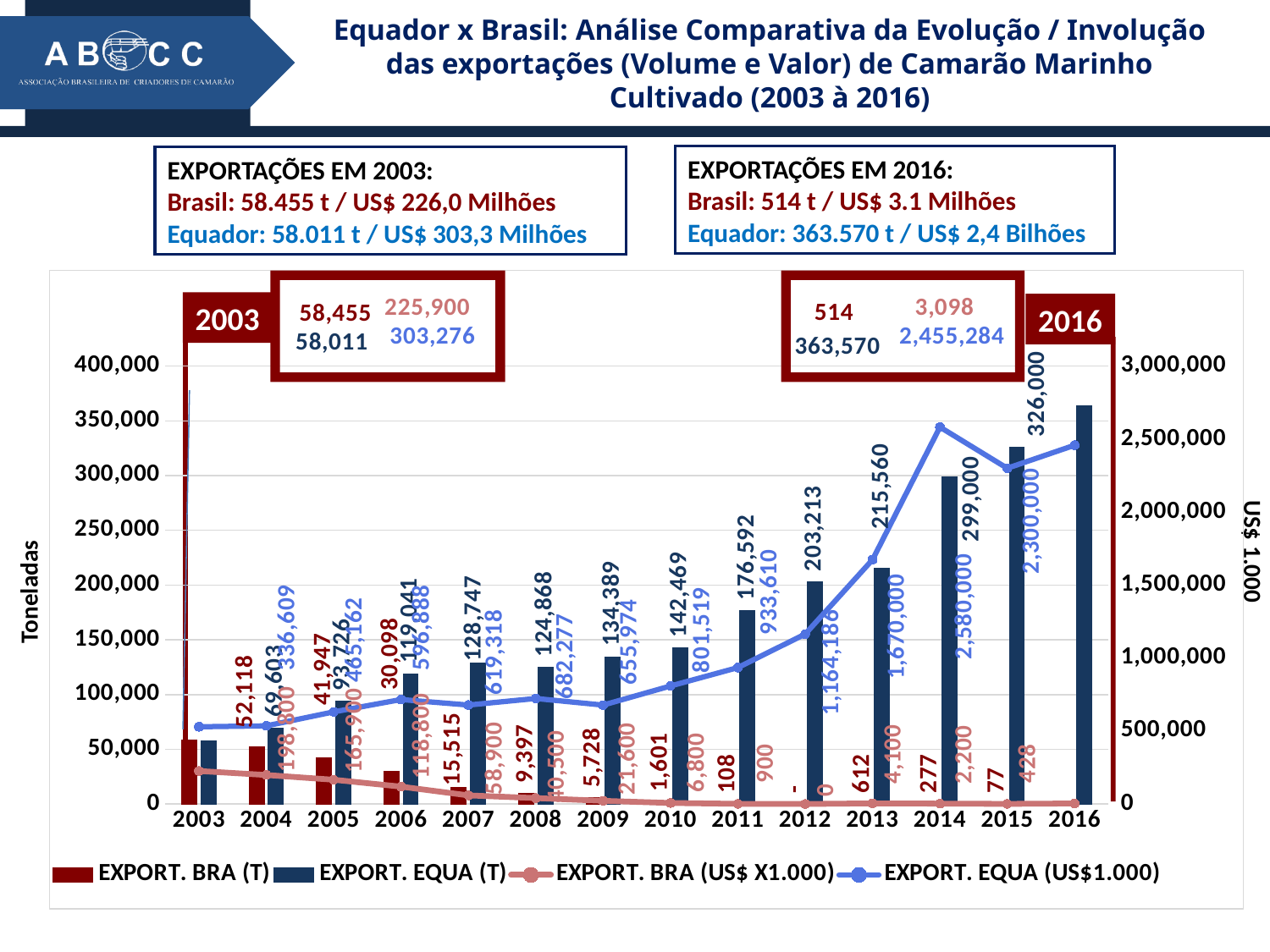
What kind of chart is this? Combined bar and line chart What is the value of EXPORT. BRA (T) in 2003? 58,455 What is the value of EXPORT. EQUA (T) in 2016? 363,570 How many series does the legend list? 4 What is the value of EXPORT. BRA (US$ X1.000) in 2007? 58,900 In which year is EXPORT. EQUA (US$1.000) highest? 2014 What is the value of EXPORT. EQUA (US$1.000) in 2014? 2,580,000 In which year is EXPORT. EQUA (T) highest? 2016 Does EXPORT. BRA (T) generally rise or fall from 2003 to 2016? Fall Which is larger in 2005: EXPORT. EQUA (T) or EXPORT. BRA (T)? EXPORT. EQUA (T) How many years are shown on the x axis? 14 What is the difference between EXPORT. EQUA (T) and EXPORT. BRA (T) in 2003? 444